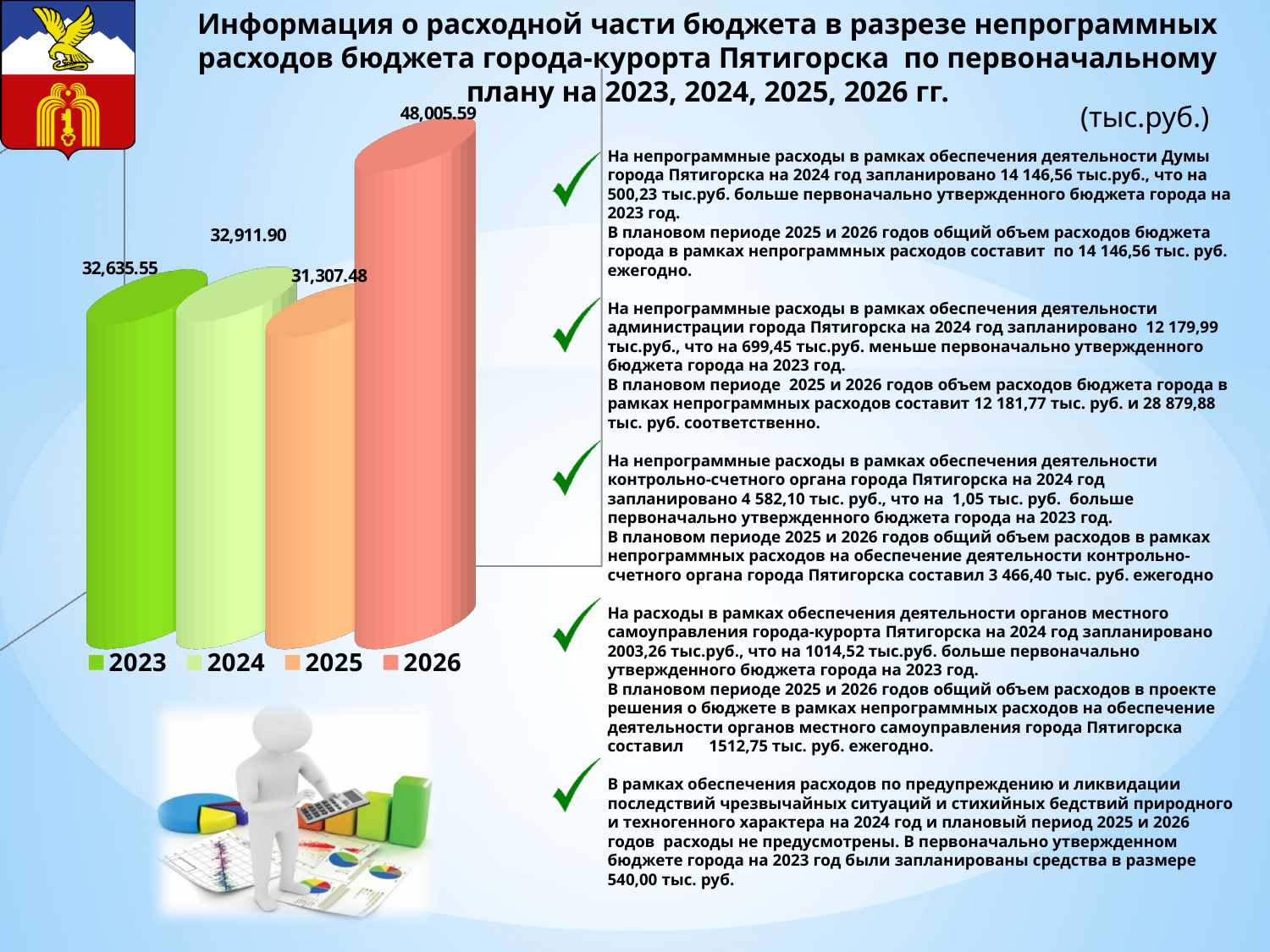
Which year has the highest value on the chart? 2026 How many entries does the chart legend list? 4 How many bars are plotted on the chart? 4 Which is larger, the value for 2026 or the value for 2025? 2026 What is the value shown for 2023 on the chart? 32,635.55 What is the difference between the values for 2026 and 2023? 15,370.04 What is the difference between the values for 2024 and 2025? 1,604.42 What is the value shown for 2024 on the chart? 32,911.90 What is the value shown for 2025 on the chart? 31,307.48 What is the value shown for 2026 on the chart? 48,005.59 What kind of chart is shown on the slide? bar chart Which year has the lowest value on the chart? 2025